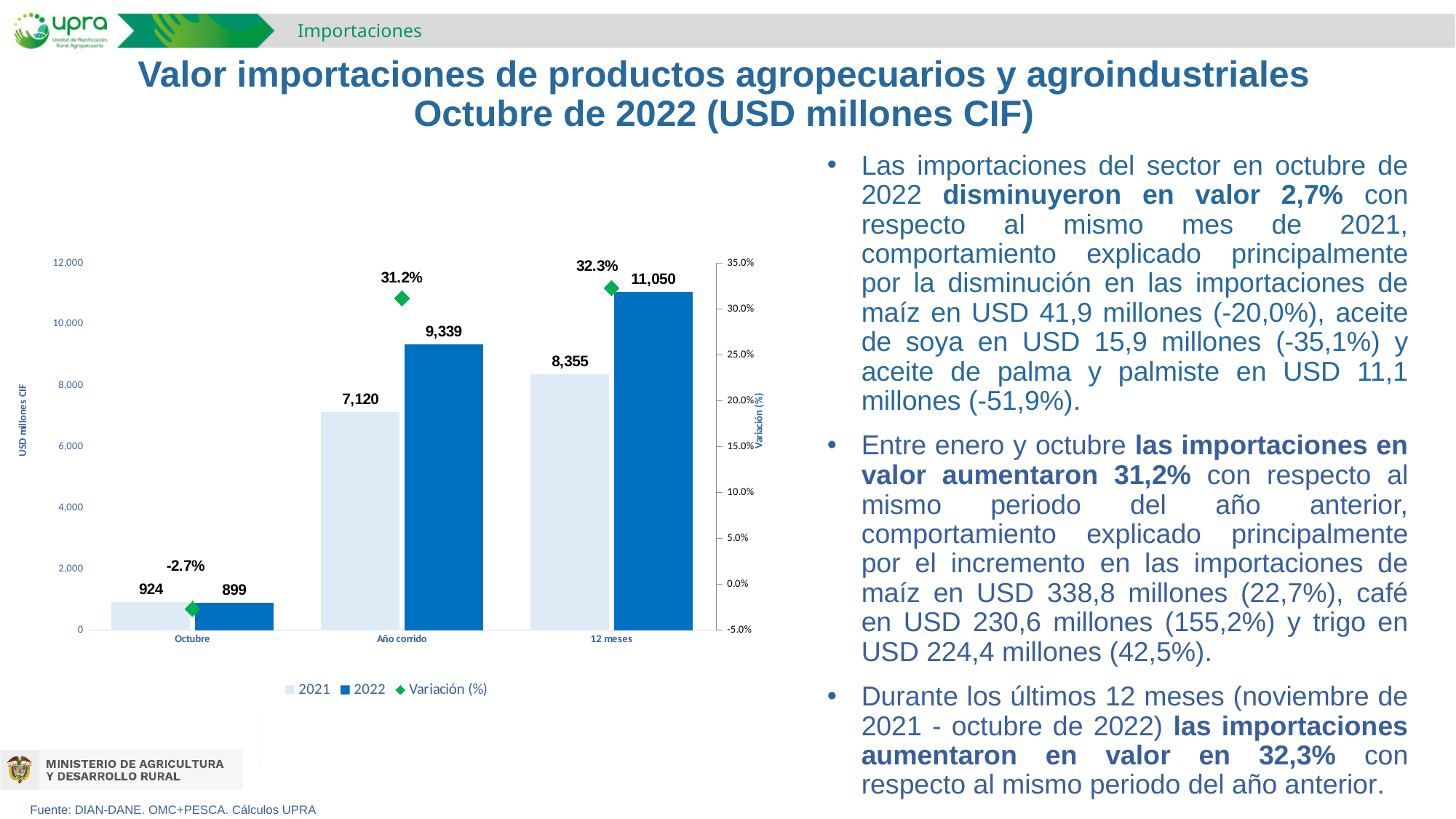
Which category has the highest 2022 value? 12 meses What is the label of the left vertical axis? USD millones CIF Which category has the lowest 2021 value? Octubre What is the difference between the 2022 and 2021 values for 12 meses? 2,695 What is the 2022 value for Octubre? 899 How many series does the legend list? 3 What is the 2021 value for Año corrido? 7,120 How many categories are shown on the x axis? 3 What kind of chart is this? Bar chart with a line/marker series Which is larger for Octubre, the 2021 value or the 2022 value? 2021 What is the Variación (%) for 12 meses? 32.3% What is the Variación (%) for Octubre? -2.7%